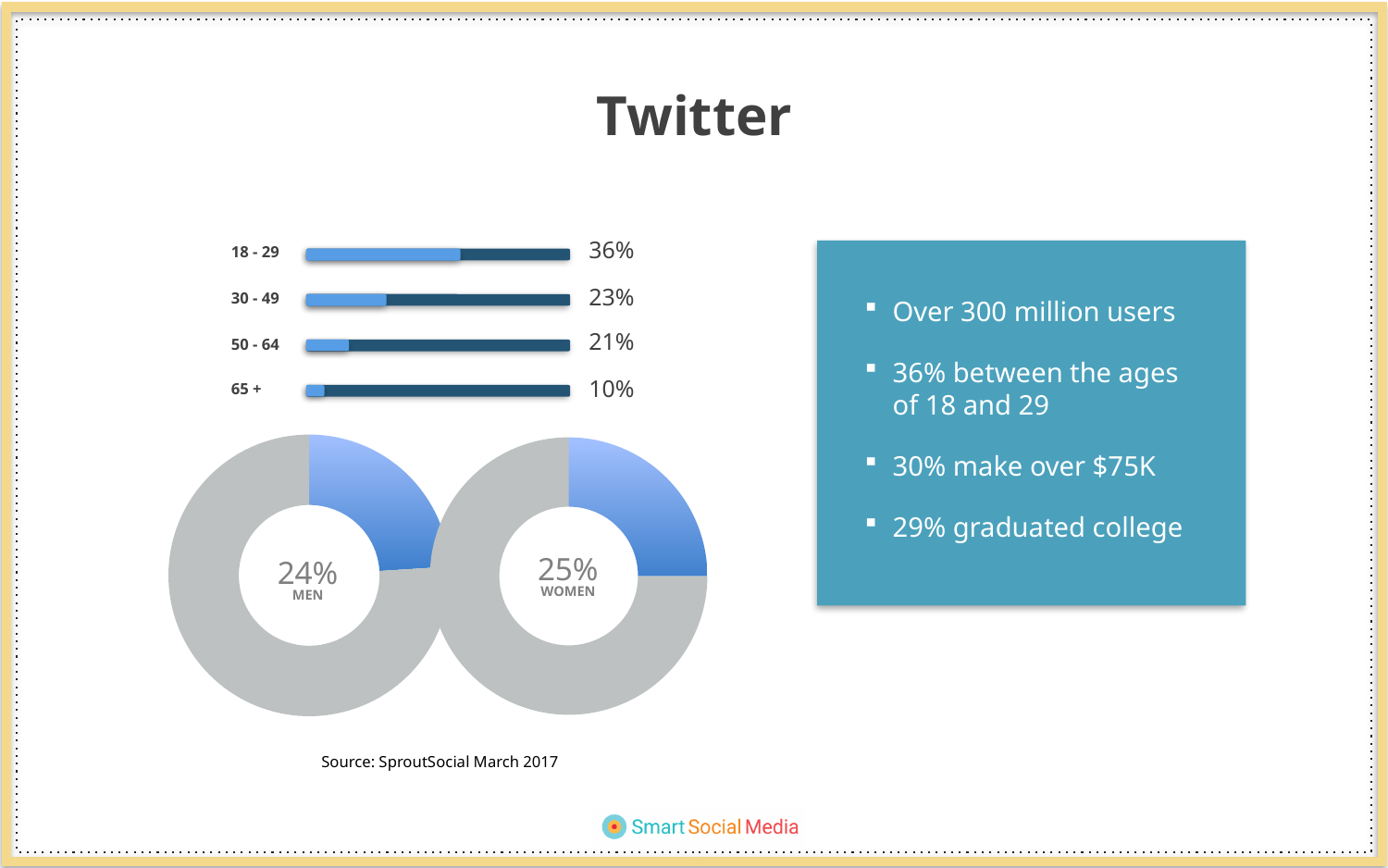
What kind of chart is used to show the age groups? Bar chart In the age-group bar chart, what is the value for the 18 - 29 group? 36% In the age-group bar chart, which age group has the highest value? 18 - 29 In the age-group bar chart, which is larger, the value for 50 - 64 or the value for 65 +? 50 - 64 In the age-group bar chart, what is the value for the 65 + group? 10% In the age-group bar chart, which age group has the lowest value? 65 + In the age-group bar chart, what is the value for the 30 - 49 group? 23% In the Women donut chart, what percentage is shown? 25% In the Men donut chart, what percentage is shown? 24% In the age-group bar chart, what is the difference between the 18 - 29 value and the 30 - 49 value? 13% How many age groups are shown in the age-group bar chart? 4 In the age-group bar chart, do the values rise or fall as the age groups get older from top to bottom? Fall